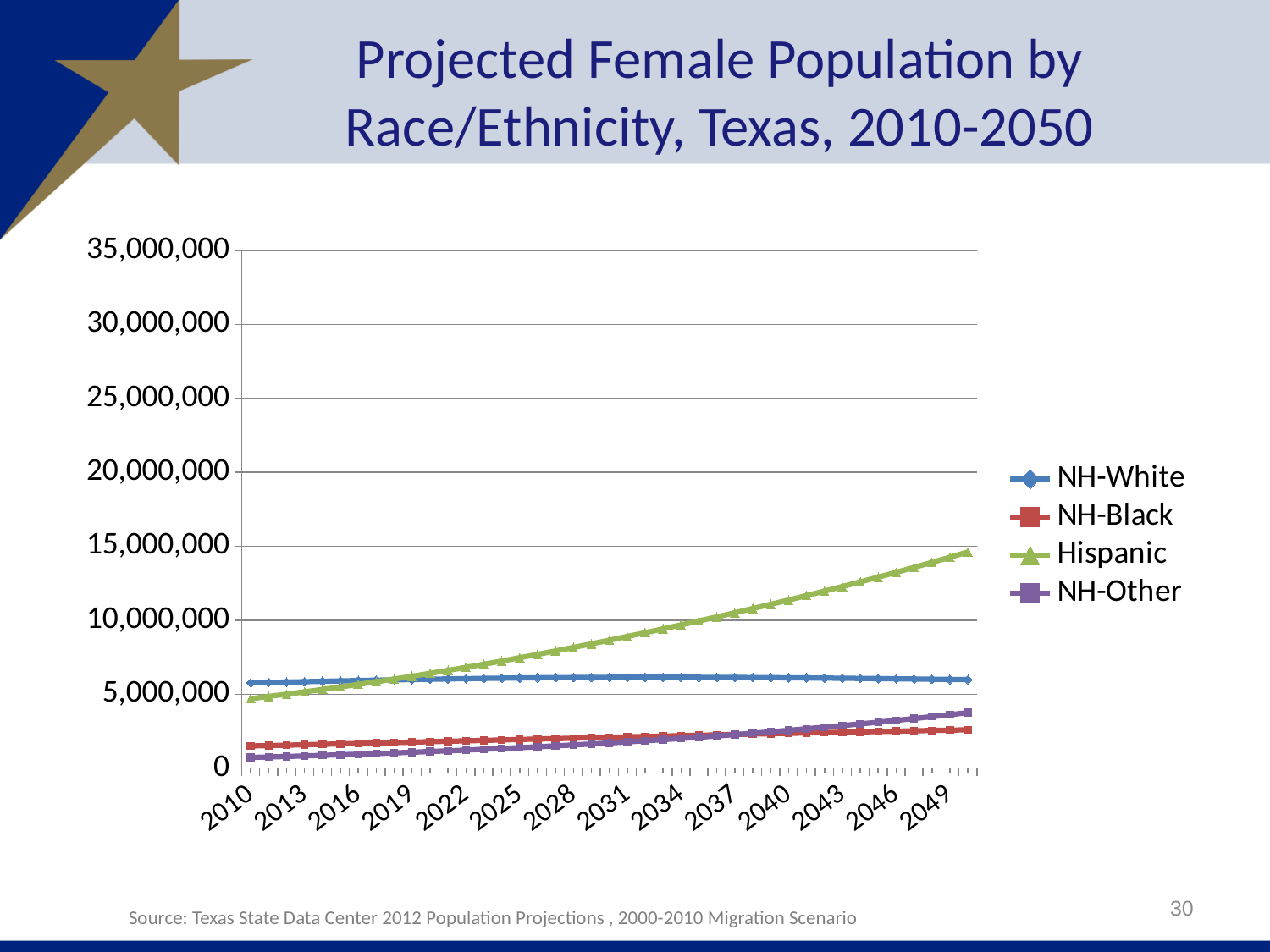
Which series is drawn in green? Hispanic Is the value for Hispanic in 2049 greater or less than 10,000,000? greater Does the Hispanic series rise or fall from 2010 to 2050? rise Which series has the highest value in 2049? Hispanic In 2010, which is larger, NH-White or Hispanic? NH-White In 2049, which is larger, NH-Other or NH-Black? NH-Other What kind of chart is shown on the slide? line chart Which series has the lowest value in 2010? NH-Other How many series does the legend list? 4 Does the NH-Other series rise or fall from 2010 to 2050? rise Is the value for NH-Black in 2049 greater or less than 5,000,000? less What is the title of the chart? Projected Female Population by Race/Ethnicity, Texas, 2010-2050